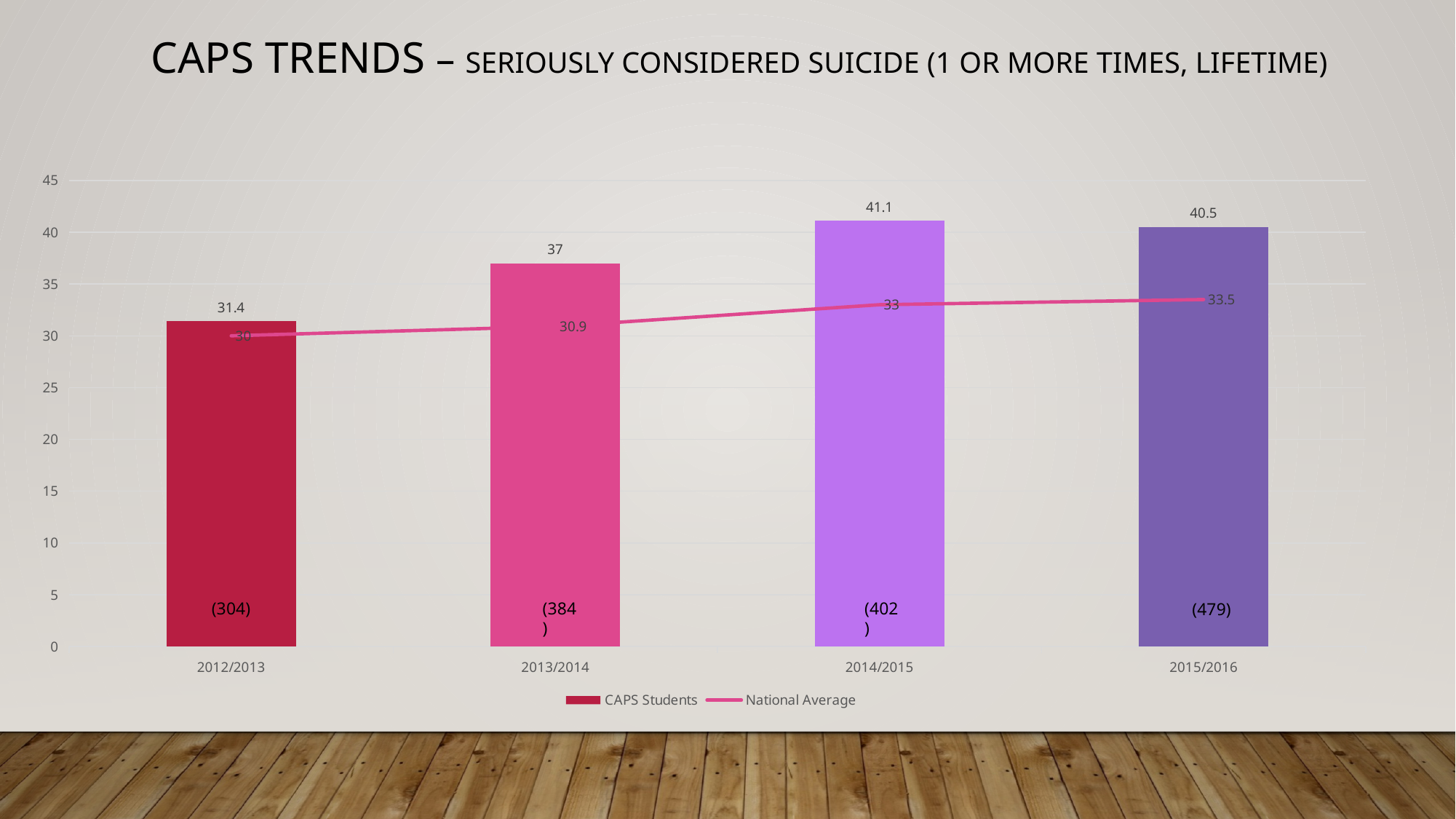
How many academic years are shown on the x axis? 4 Which year has the highest CAPS Students value? 2014/2015 What is the CAPS Students value for 2012/2013? 31.4 What is the CAPS Students value for 2014/2015? 41.1 What is the National Average value for 2013/2014? 30.9 Which is larger in 2013/2014, the CAPS Students value or the National Average value? CAPS Students What is the National Average value for 2015/2016? 33.5 How many series does the legend list? 2 What is the difference between the CAPS Students value and the National Average value in 2015/2016? 7 Which year has the lowest CAPS Students value? 2012/2013 Does the National Average rise or fall from 2012/2013 to 2015/2016? Rise What kind of chart is used for the CAPS Students series? Bar chart